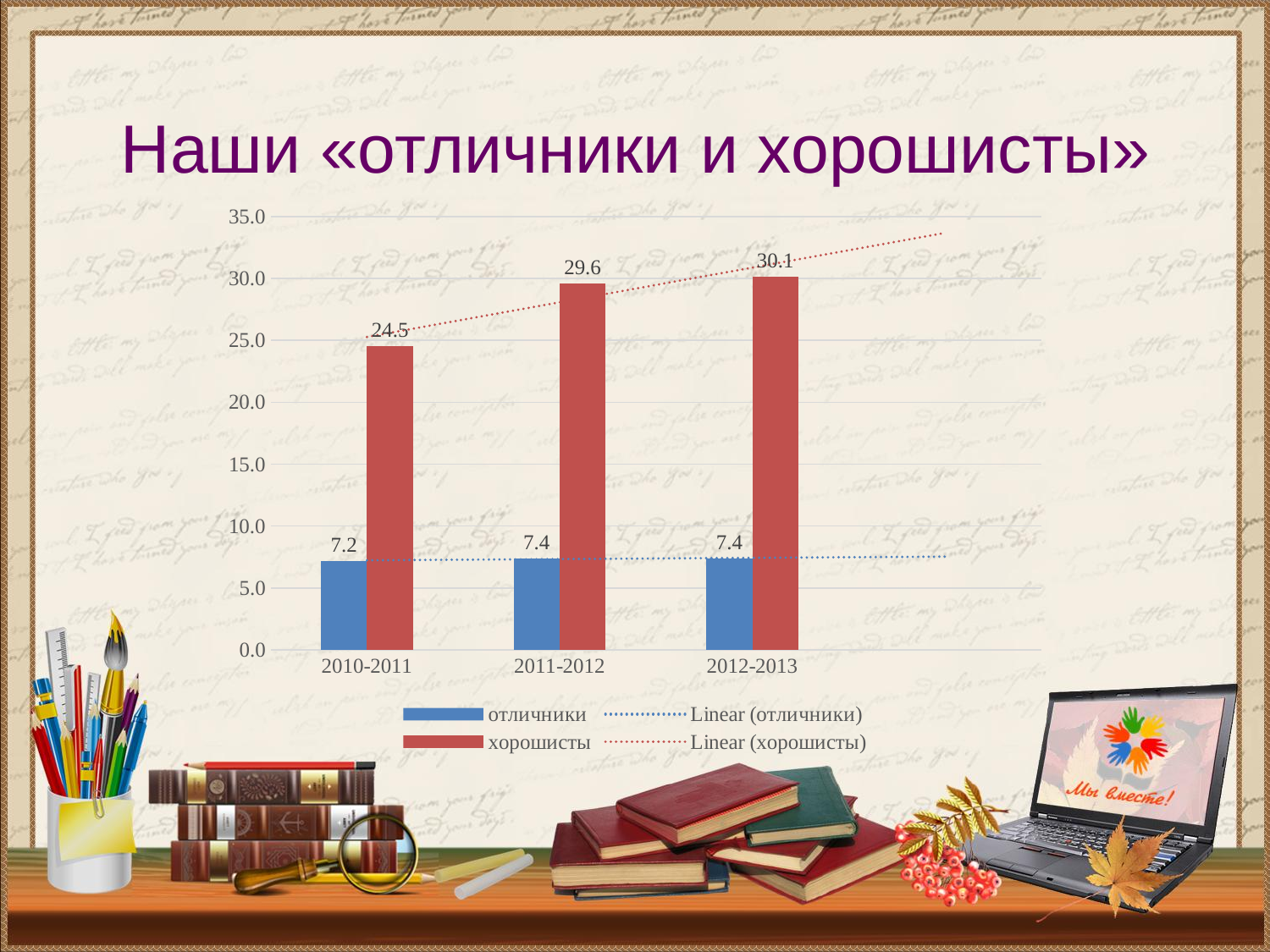
What is the difference between the хорошисты values for 2012-2013 and 2010-2011? 5.6 Is the value for хорошисты in 2011-2012 greater or less than 25.0? greater What is the value for отличники in 2011-2012? 7.4 What is the difference between хорошисты and отличники in 2011-2012? 22.2 How many year categories are shown on the x axis? 3 What is the value for хорошисты in 2012-2013? 30.1 Which is larger in 2010-2011: отличники or хорошисты? хорошисты In which year is the value for хорошисты the highest? 2012-2013 In which year is the value for хорошисты the lowest? 2010-2011 What is the value for хорошисты in 2010-2011? 24.5 What kind of chart is shown on the slide? bar chart Do the values for хорошисты rise or fall from 2010-2011 to 2012-2013? rise